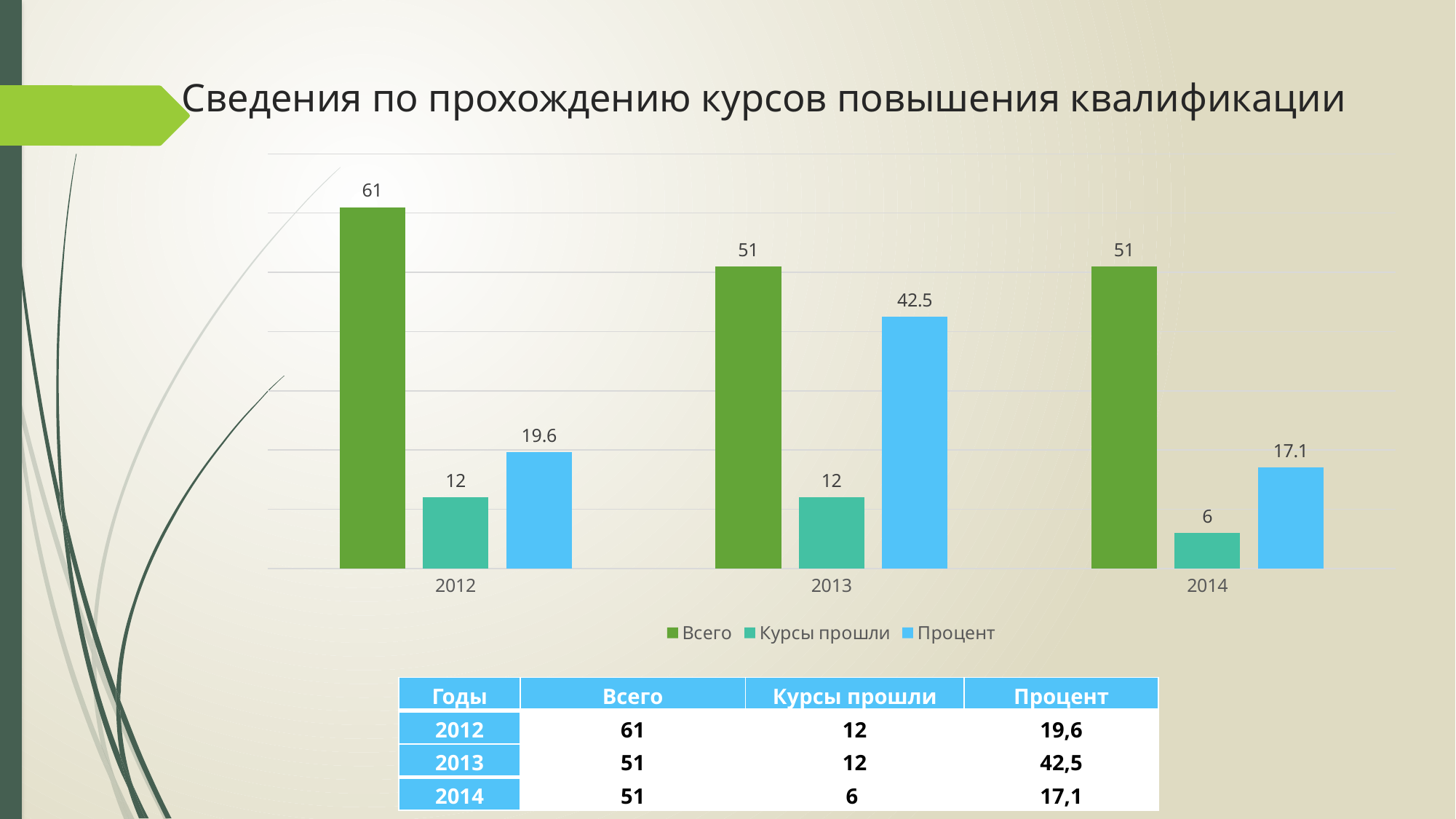
In which year is the Процент value highest? 2013 In which year is the Курсы прошли value lowest? 2014 What is the title of the slide containing the chart? Сведения по прохождению курсов повышения квалификации How many series does the chart legend list? 3 What is the value of Всего for 2012? 61 Which is larger: the Процент value for 2012 or for 2014? 2012 What type of chart is shown on the slide? bar chart What is the value of Процент for 2013? 42.5 How many years are shown on the x axis of the chart? 3 What is the value of Курсы прошли for 2014? 6 Does the Курсы прошли series rise or fall from 2013 to 2014? fall What is the difference between the Всего values for 2012 and 2013? 10